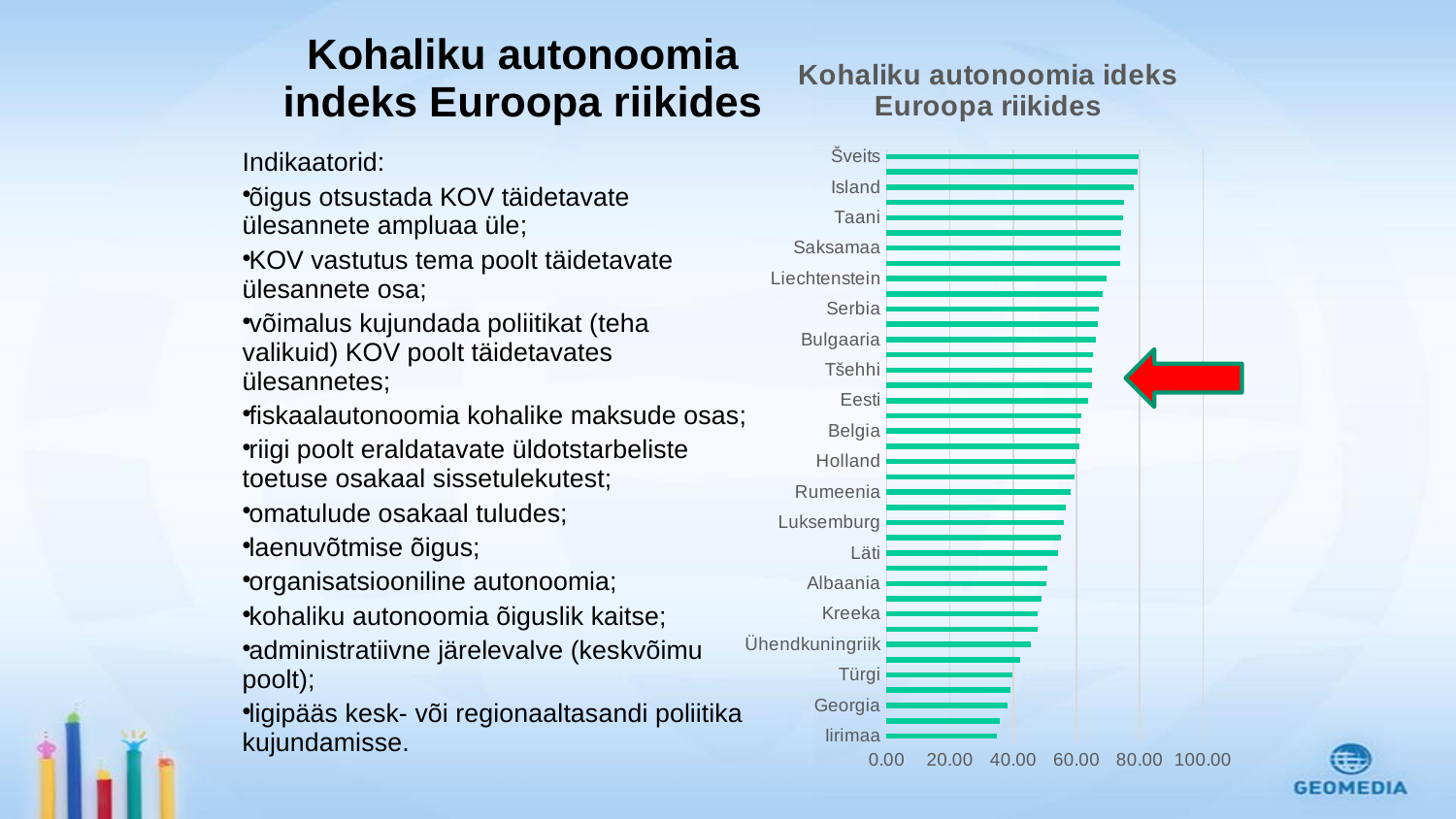
Which country has the lowest value in the chart? Iirimaa Is the value for Liechtenstein greater or less than 60.00? greater Which country has the highest value in the chart? Šveits What kind of chart is shown on the slide? bar chart What is the title of the chart? Kohaliku autonoomia ideks Euroopa riikides Do the bar values increase or decrease going from the top of the chart to the bottom? decrease Is the value for Türgi greater or less than 60.00? less Is the value for Kreeka greater or less than 40.00? greater Which has a larger value, Eesti or Kreeka? Eesti Which has a larger value, Georgia or Saksamaa? Saksamaa